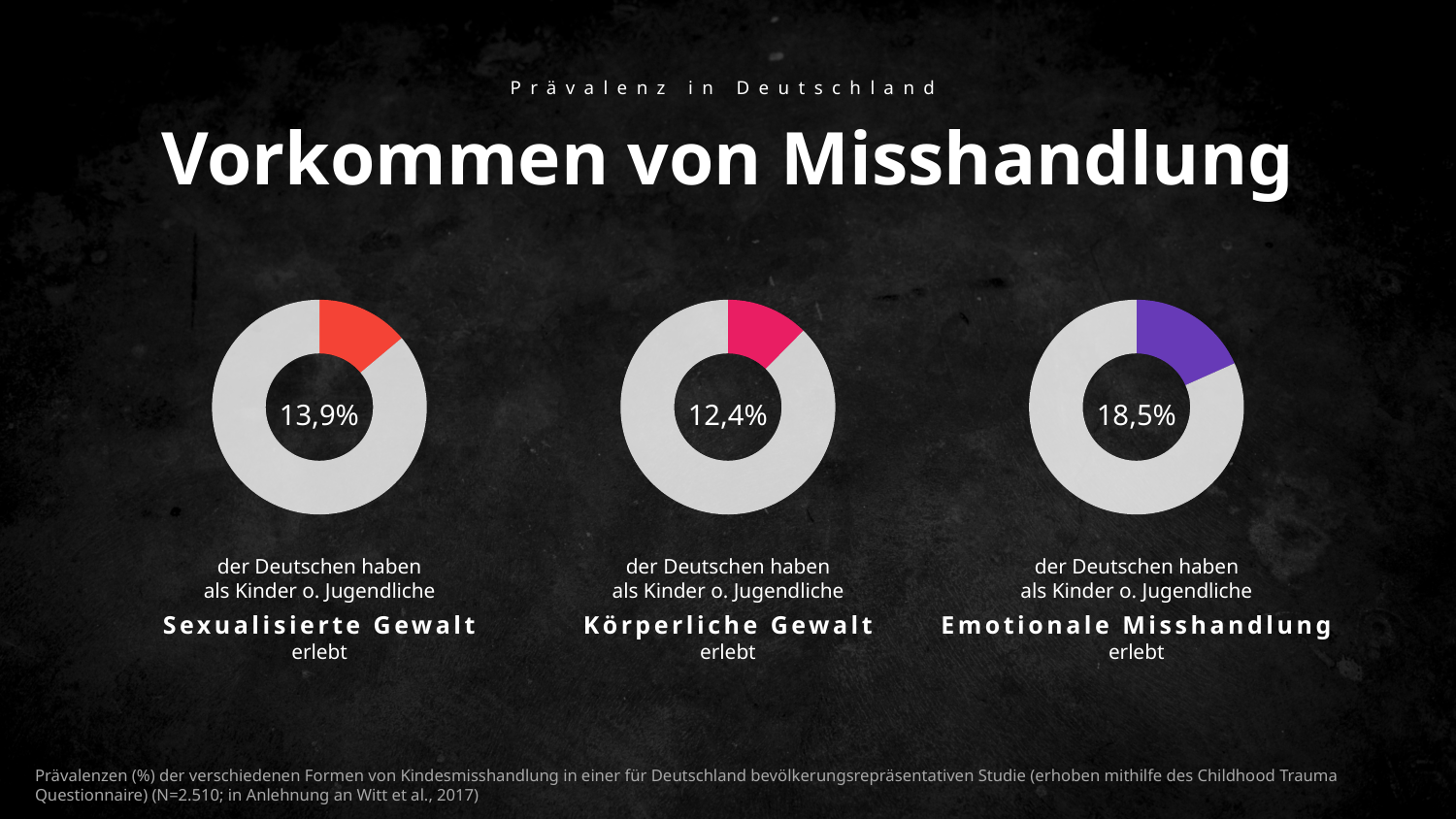
What is the difference in percentage points between the Sexualisierte Gewalt chart and the Körperliche Gewalt chart? 1,5 What kind of chart is used to display the prevalence values on the slide? Donut (pie) chart What percentage is shown in the left donut chart for Sexualisierte Gewalt? 13,9% What percentage is shown in the right donut chart for Emotionale Misshandlung? 18,5% How many donut charts are shown on the slide? 3 Which of the three forms of maltreatment has the highest prevalence shown on the slide? Emotionale Misshandlung What percentage is shown in the middle donut chart for Körperliche Gewalt? 12,4% Is the prevalence for Sexualisierte Gewalt or for Körperliche Gewalt larger? Sexualisierte Gewalt What colour is the highlighted slice in the right donut chart for Emotionale Misshandlung? Purple Which of the three forms of maltreatment has the lowest prevalence shown on the slide? Körperliche Gewalt What is the difference in percentage points between the Emotionale Misshandlung chart and the Körperliche Gewalt chart? 6,1 What is the main title of the slide? Vorkommen von Misshandlung